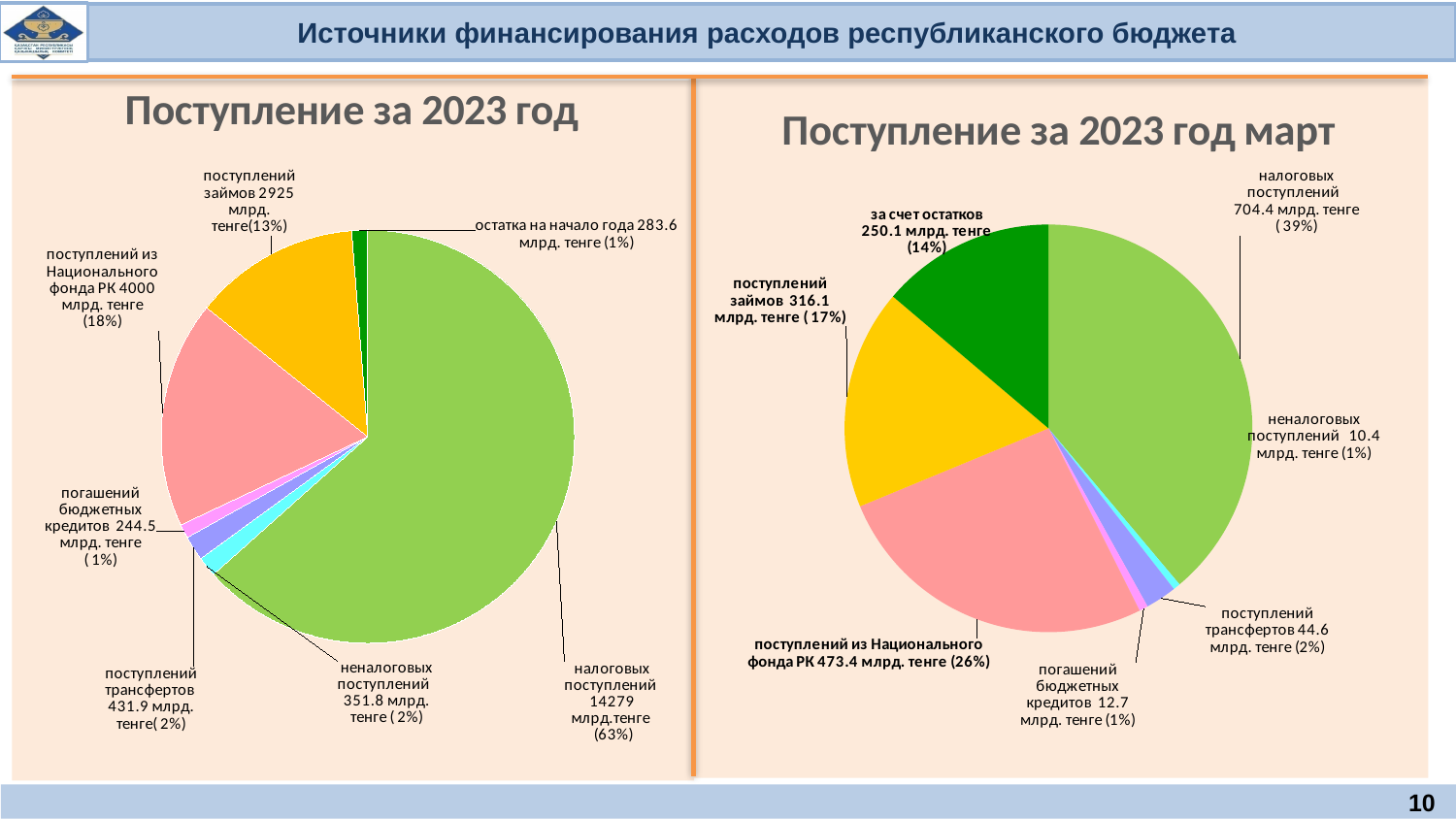
On the chart 'Поступление за 2023 год март', what share of the pie is за счет остатков? 14% On the chart 'Поступление за 2023 год март', what value is shown for поступлений из Национального фонда РК? 473.4 млрд. тенге (26%) On the chart 'Поступление за 2023 год', how many slices does the pie have? 7 On the chart 'Поступление за 2023 год март', which is larger: поступлений займов or за счет остатков? поступлений займов On the chart 'Поступление за 2023 год март', what is the difference between налоговых поступлений and поступлений из Национального фонда РК in млрд. тенге? 231 млрд. тенге On the chart 'Поступление за 2023 год', which category has the largest slice? налоговых поступлений On the chart 'Поступление за 2023 год', what share of the pie is поступлений из Национального фонда РК? 18% On the chart 'Поступление за 2023 год март', which category has the largest slice? налоговых поступлений On the chart 'Поступление за 2023 год', what is the difference between поступлений из Национального фонда РК and поступлений займов in млрд. тенге? 1075 млрд. тенге What is the title of the chart on the left side of the slide? Поступление за 2023 год On the chart 'Поступление за 2023 год', what value is shown for налоговых поступлений? 14279 млрд.тенге (63%) What type of chart is 'Поступление за 2023 год март'? pie chart